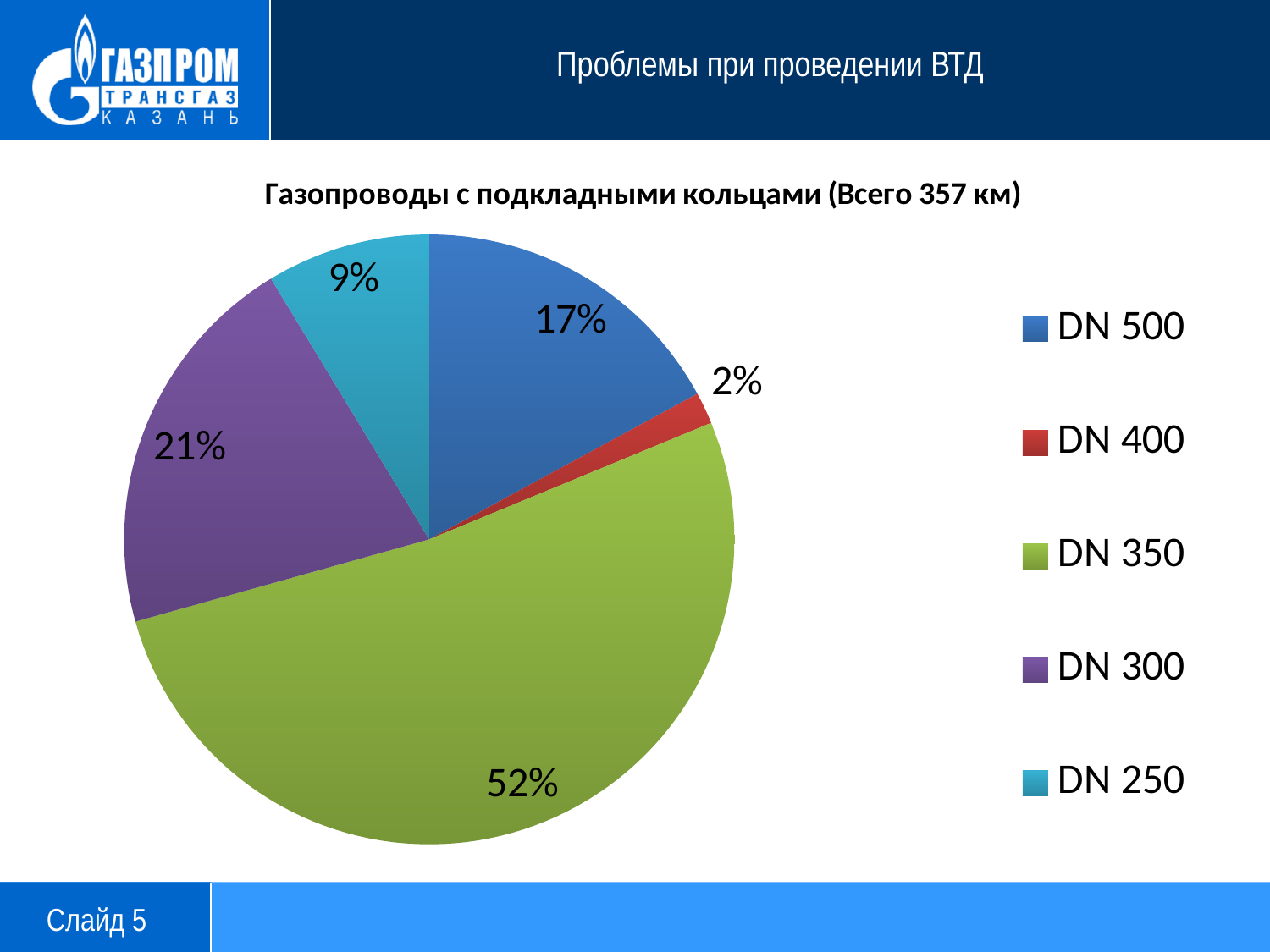
What share of the pie does DN 400 have? 2% What share of the pie does DN 250 have? 9% What share of the pie does DN 300 have? 21% What is the difference in percentage points between the DN 350 share and the DN 300 share? 31 How many categories does the legend list? 5 Which category has the smallest slice of the pie? DN 400 Which category has the largest slice of the pie? DN 350 Which is larger, the share for DN 300 or the share for DN 500? DN 300 What is the title of the chart? Газопроводы с подкладными кольцами (Всего 357 км) What kind of chart is shown on the slide? pie chart